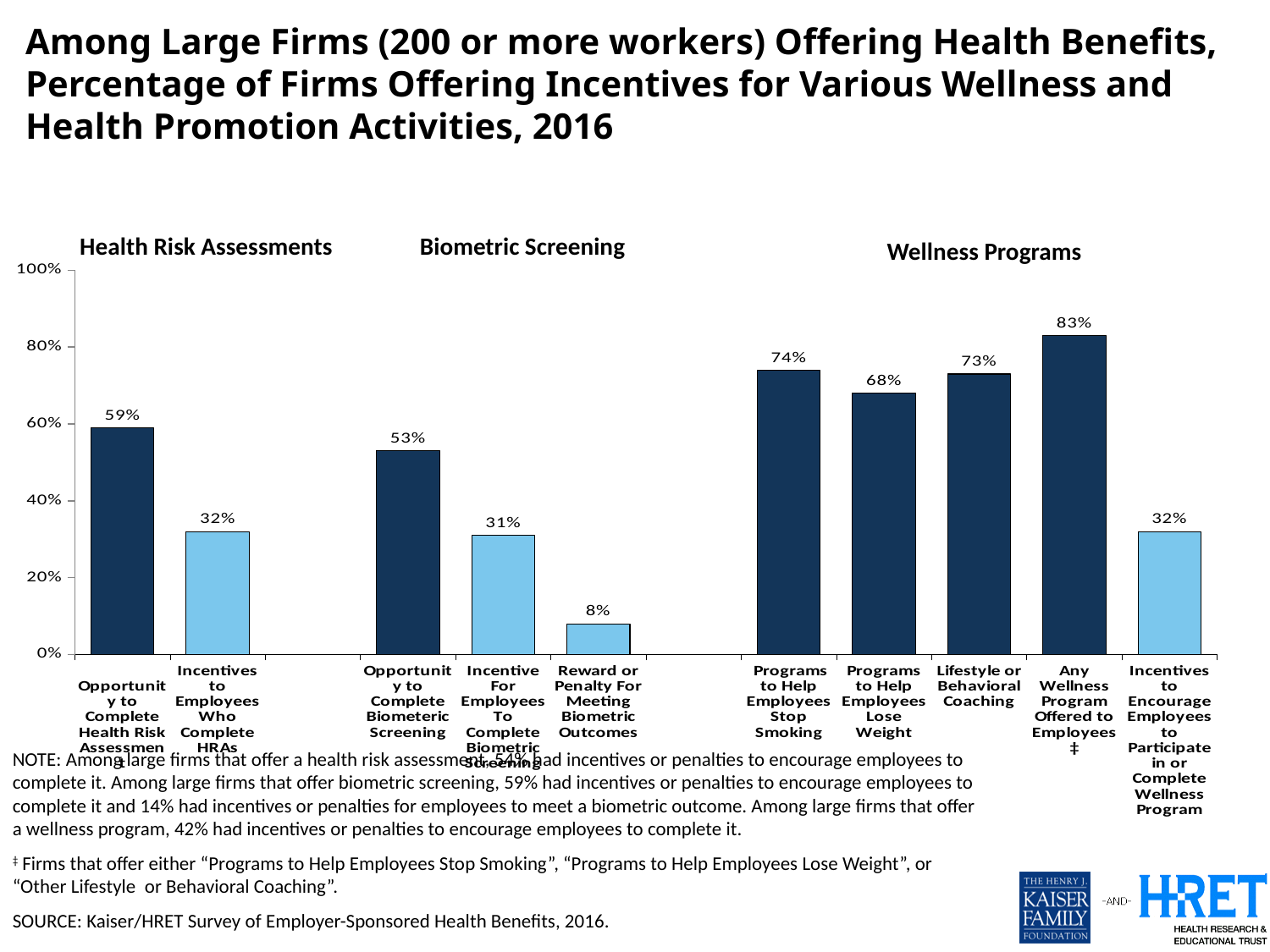
Which is larger: the value for "Programs to Help Employees Stop Smoking" or the value for "Programs to Help Employees Lose Weight"? Programs to Help Employees Stop Smoking Which category has the highest value on the chart? Any Wellness Program Offered to Employees What percentage of large firms offer programs to help employees stop smoking? 74% What is the value for "Any Wellness Program Offered to Employees"? 83% What is the value for "Lifestyle or Behavioral Coaching"? 73% What percentage of firms offer a reward or penalty for meeting biometric outcomes? 8% How many bars are plotted on the chart in total? 10 What are the three group headings shown above the bars? Health Risk Assessments, Biometric Screening, Wellness Programs What kind of chart is shown on the slide? Bar chart Which category has the lowest value on the chart? Reward or Penalty For Meeting Biometric Outcomes What is the difference between the value for "Opportunity to Complete Health Risk Assessment" and the value for "Incentives to Employees Who Complete HRAs"? 27% What is the difference between the value for "Opportunity to Complete Biometric Screening" and the value for "Incentive For Employees To Complete Biometric Screening"? 22%